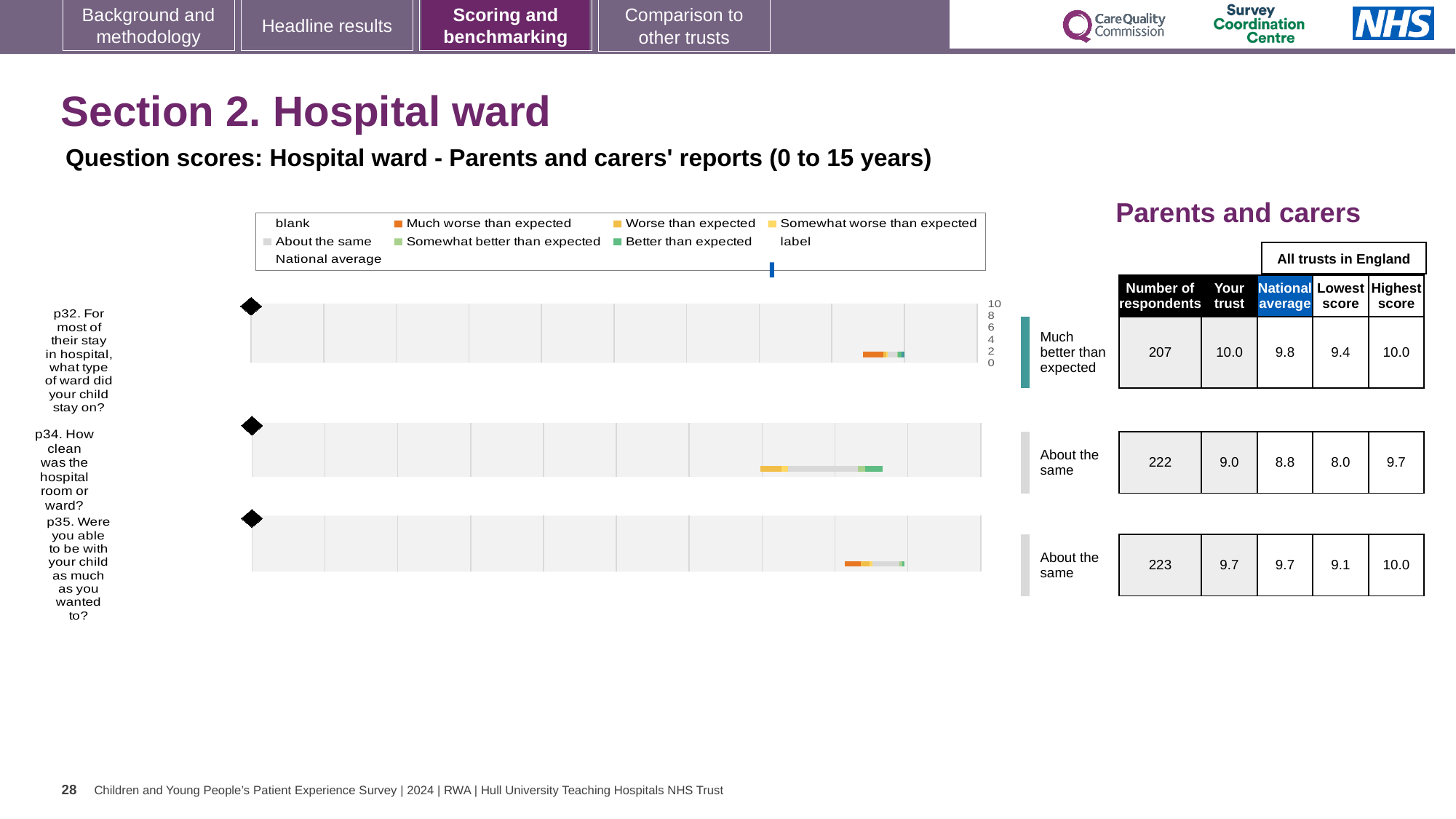
For p32, which is larger: the 'Your trust' score or the national average? Your trust In the table next to the chart, what is the number of respondents for p32 (what type of ward did your child stay on)? 207 What kind of chart is used to show the question scores for the hospital ward section? bar chart What is the lowest score among all trusts in England for p34? 8.0 What is the national average score for p35 (were you able to be with your child as much as you wanted to)? 9.7 Which of the three questions has the highest 'Your trust' score? p32 How many questions (rows) are plotted in the hospital ward chart? 3 Which of the three questions has the lowest 'Your trust' score? p34 What is the 'Your trust' score for p34 (how clean was the hospital room or ward)? 9.0 What is the heading above the Lowest score and Highest score columns in the table? All trusts in England What benchmark category is shown for p32 (what type of ward did your child stay on)? Much better than expected What is the difference between the 'Your trust' score and the national average for p34? 0.2